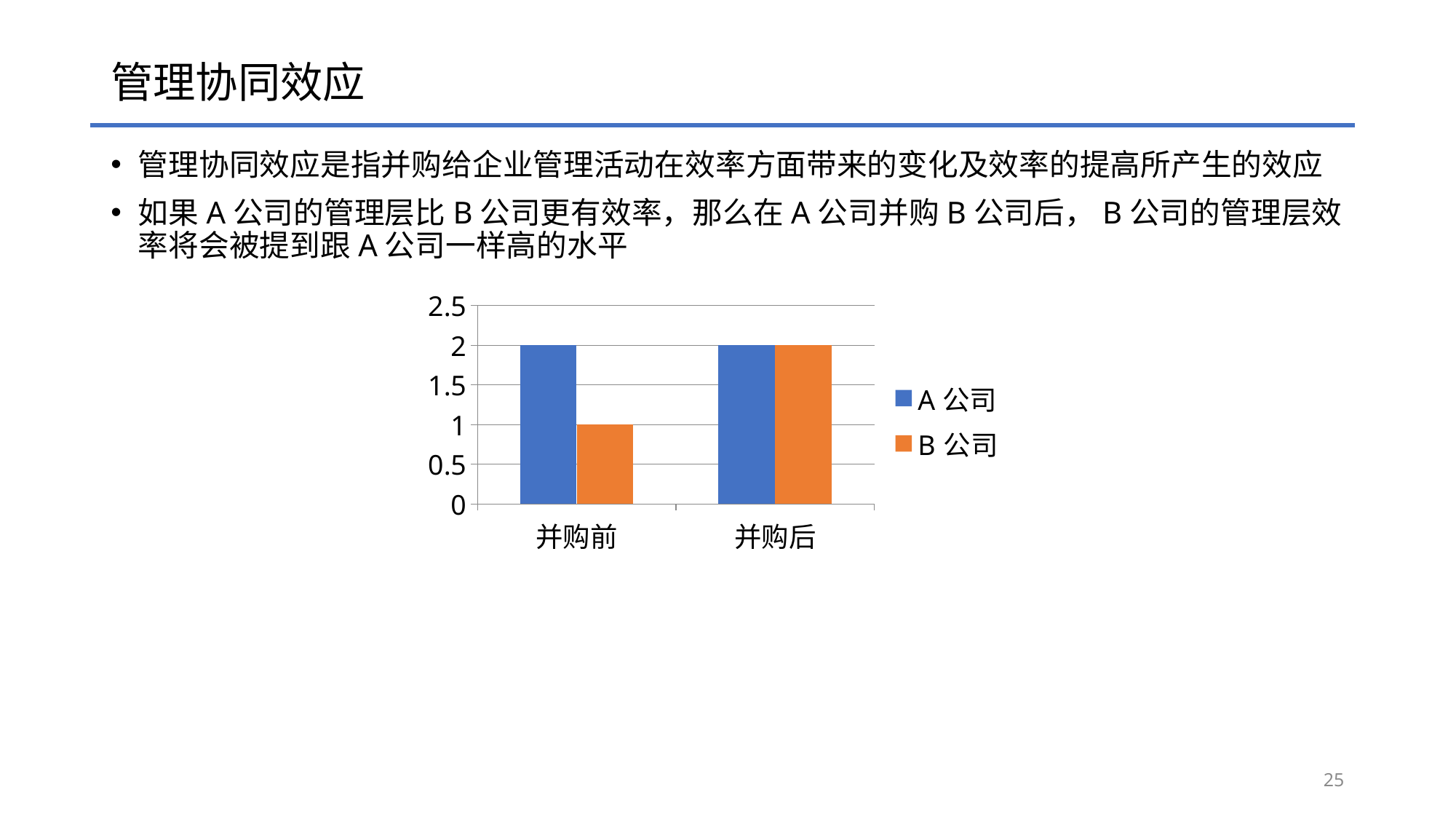
What is the difference between the A 公司 and B 公司 values in the 并购前 category? 1 What kind of chart is shown on the slide? bar chart How many series does the chart legend list? 2 Which series has the lower value in the 并购前 category? B 公司 What colour are the bars for B 公司 in the chart? orange What is the value for A 公司 in the 并购前 category? 2 What is the value for A 公司 in the 并购后 category? 2 How many categories are shown on the x axis of the chart? 2 What is the value for B 公司 in the 并购前 category? 1 Does the value for B 公司 rise or fall from 并购前 to 并购后? rise In the 并购前 category, which is larger, the value for A 公司 or the value for B 公司? A 公司 What is the value for B 公司 in the 并购后 category? 2